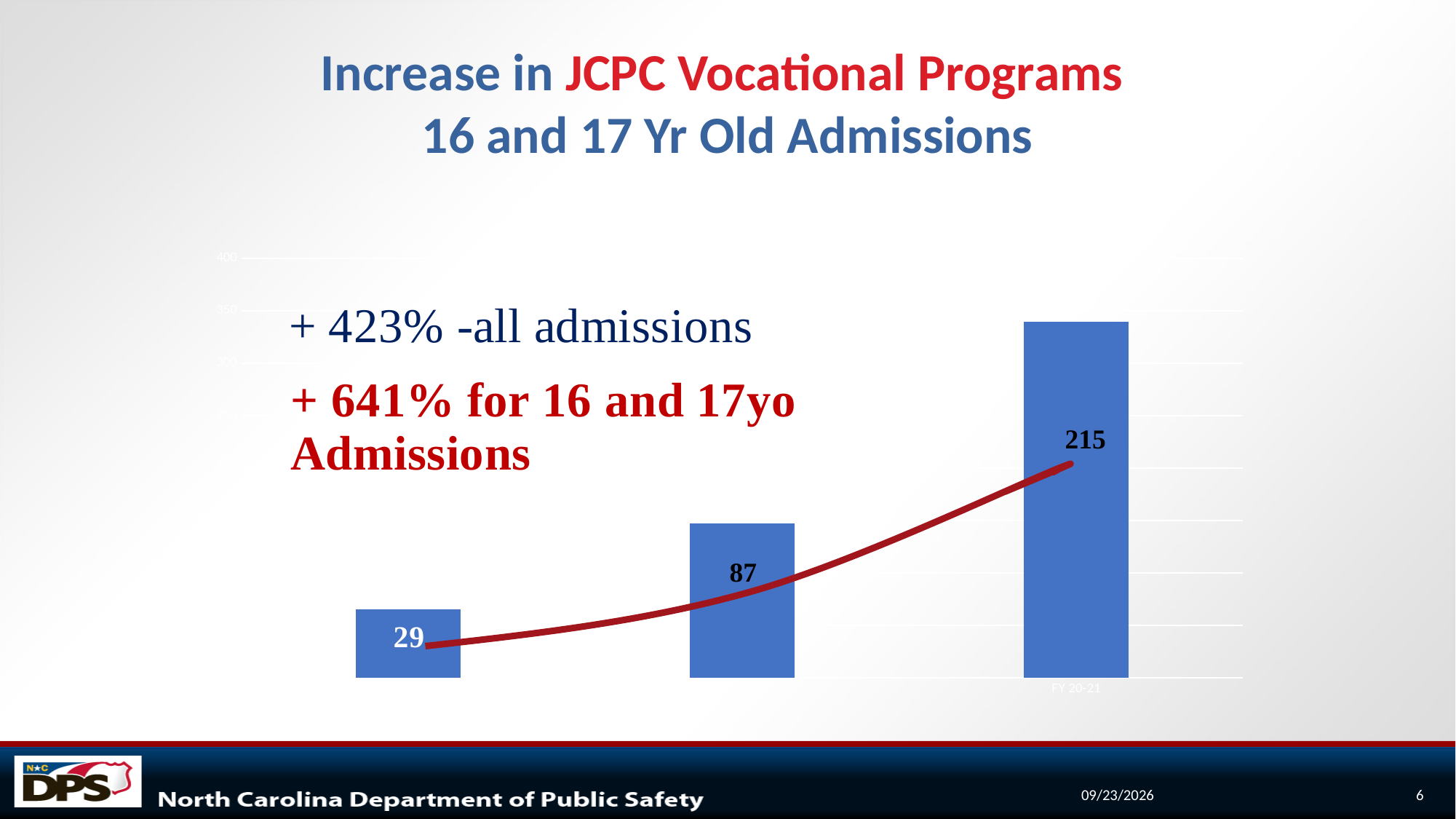
Which is larger, the middle bar or the FY 20-21 bar? FY 20-21 How many bars are plotted in the chart? 3 What colour is the curved line drawn over the bars? dark red Do the bar values rise or fall from left to right? rise What type of chart is shown on the slide? bar chart